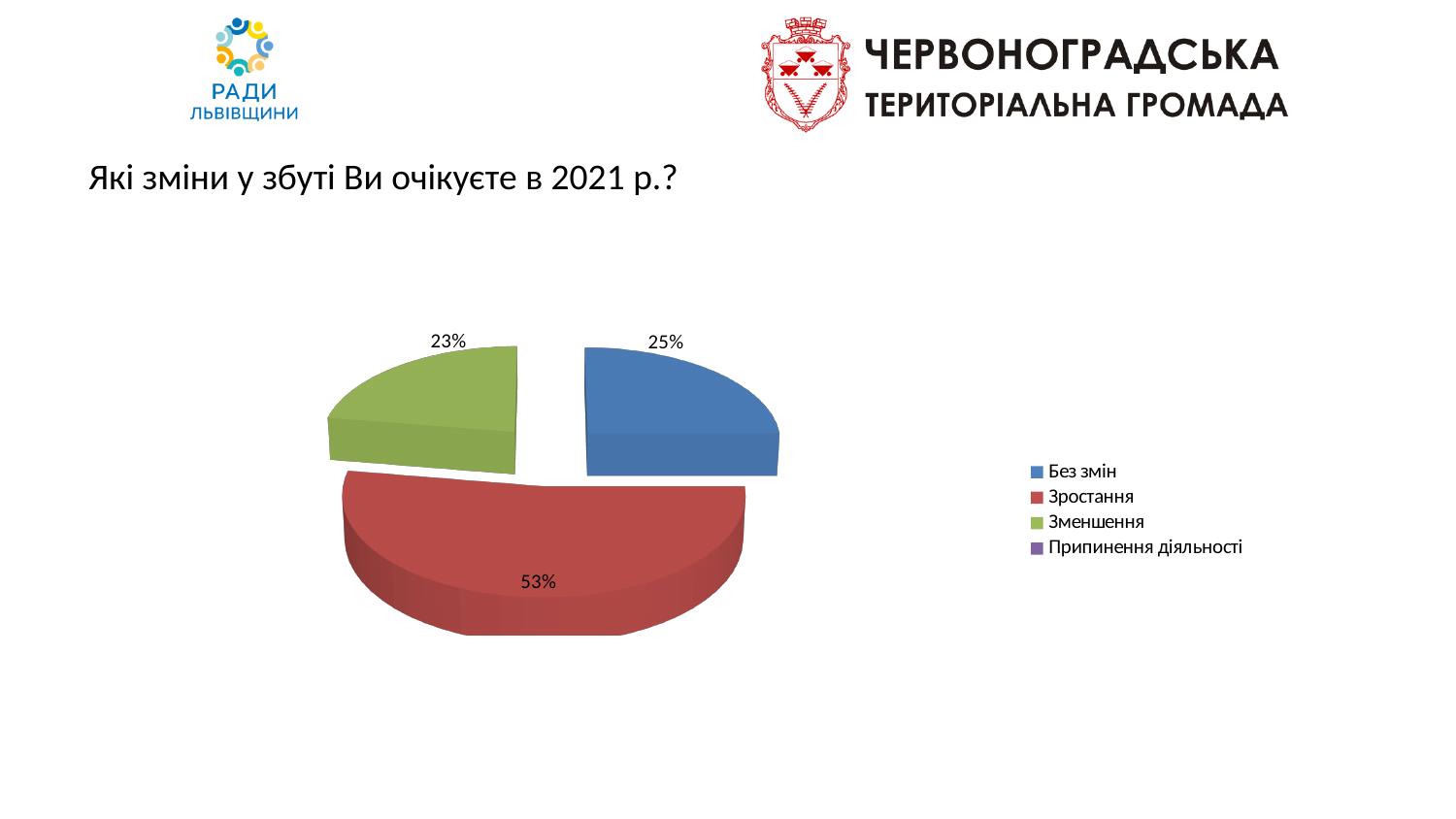
What is the difference in percentage points between the "Зростання" and "Без змін" slices? 28 What kind of chart is shown on the slide? pie chart Which category has the largest slice of the pie? Зростання Which is larger, the "Без змін" slice or the "Зменшення" slice? Без змін What share of the pie does the "Без змін" slice represent? 25% What question is the chart titled with on the slide? Які зміни у збуті Ви очікуєте в 2021 р.? What share of the pie does the "Зменшення" slice represent? 23% What colour is the "Зростання" slice? red How many entries does the legend list? 4 What is the difference in percentage points between the "Без змін" and "Зменшення" slices? 2 What share of the pie does the "Зростання" slice represent? 53% Which of the visible slices is the smallest? Зменшення